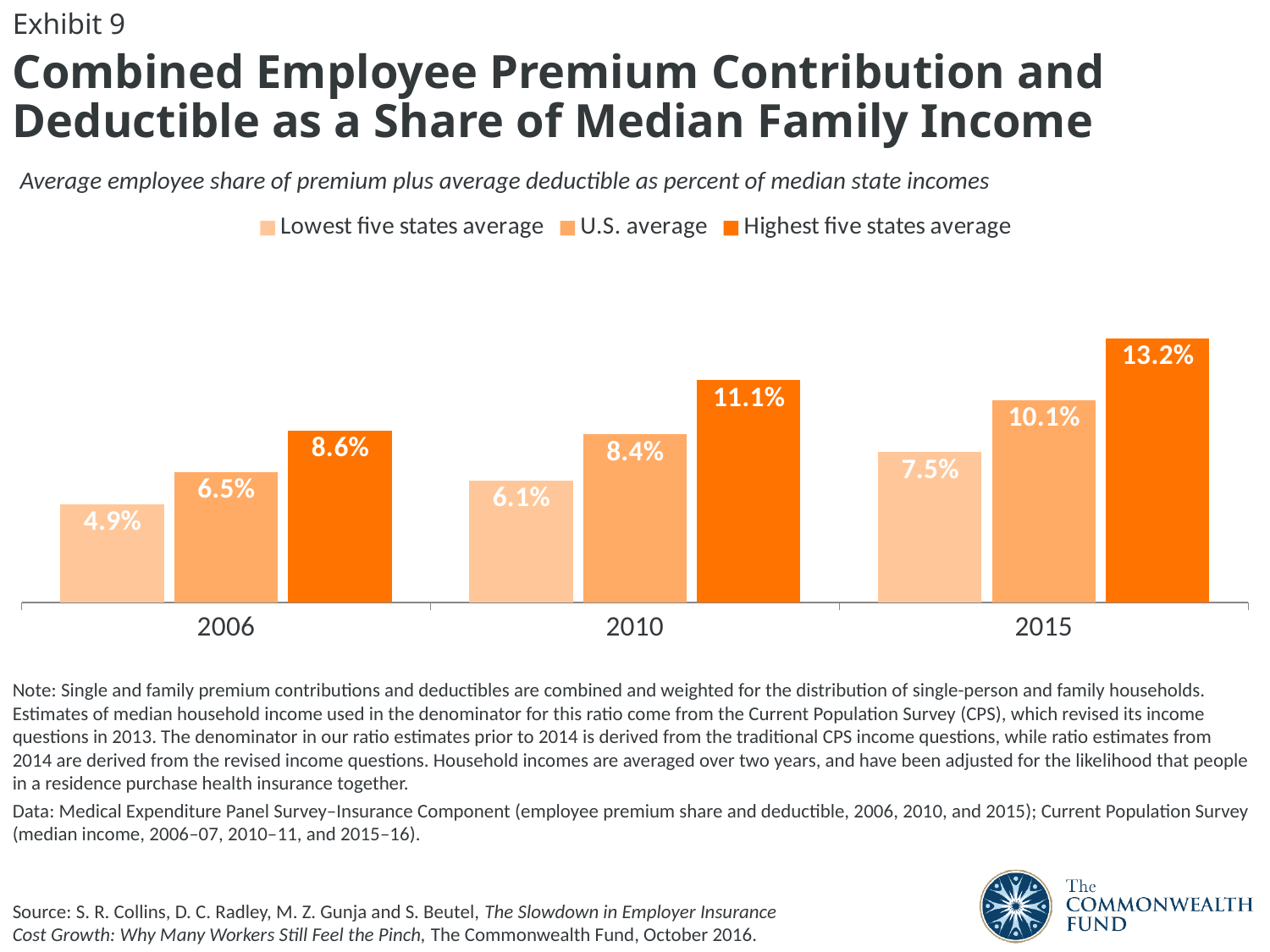
Does the Lowest five states average rise or fall from 2006 to 2015? Rise Which year has the lowest Highest five states average value? 2006 What is the Lowest five states average value for 2006? 4.9% What is the difference between the U.S. average in 2015 and the U.S. average in 2006? 3.6% What is the U.S. average value for 2010? 8.4% What is the Highest five states average value for 2015? 13.2% Which is larger: the Highest five states average in 2006 or the U.S. average in 2010? Highest five states average in 2006 What kind of chart is shown on the slide? Bar chart How many years are shown on the x axis? 3 How many series does the legend list? 3 Which year has the highest U.S. average value? 2015 What is the difference between the Highest five states average and the Lowest five states average in 2015? 5.7%